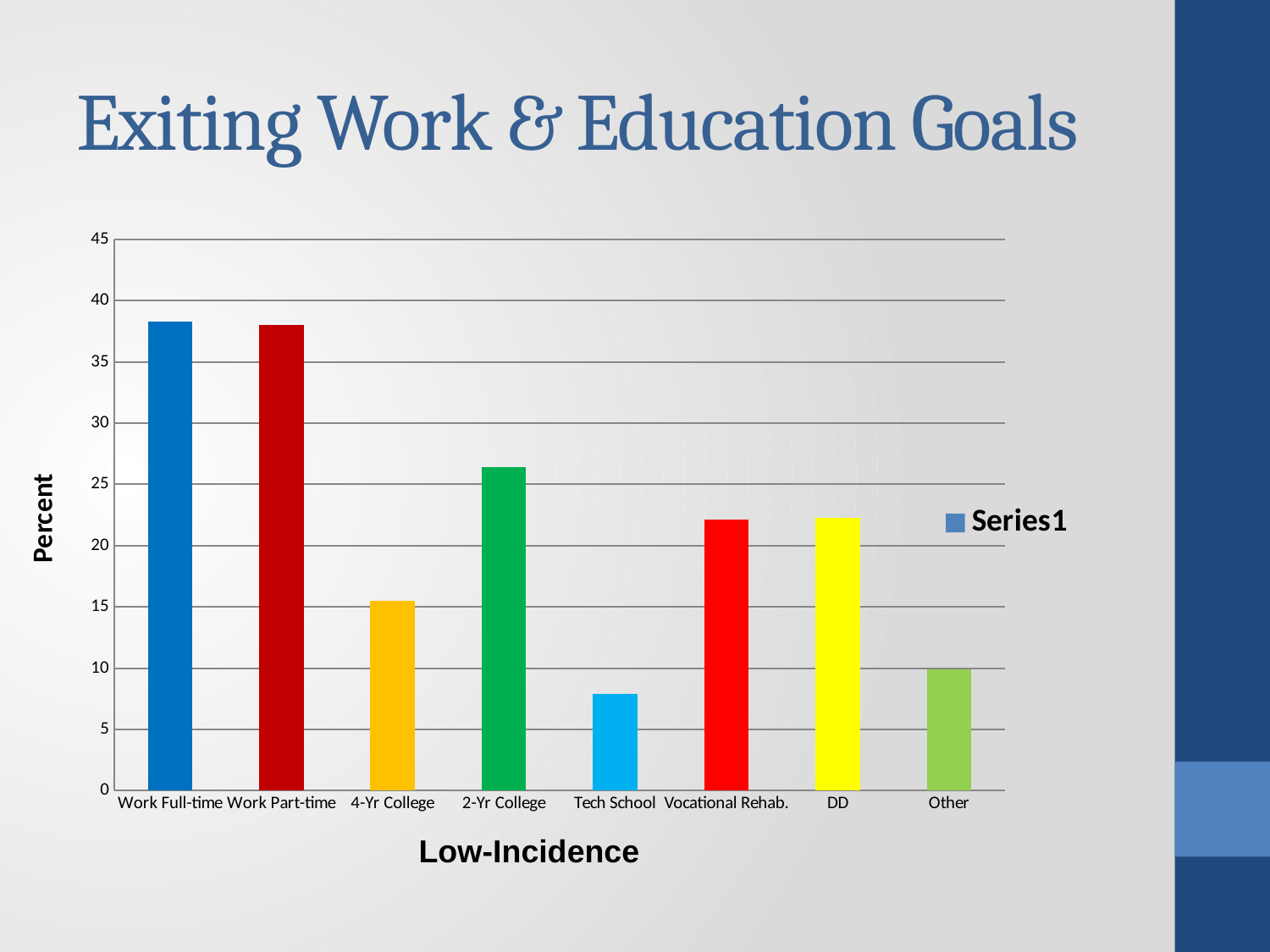
What is the title of the y axis of the chart? Percent What kind of chart is shown on the slide? bar chart Is the value for Vocational Rehab. greater or less than 20? greater Is the value for Work Full-time greater or less than 35? greater Which category has the lowest value in the chart? Tech School Is the value for 2-Yr College greater or less than 25? greater How many series does the chart legend list? 1 Which is larger, the value for 2-Yr College or the value for 4-Yr College? 2-Yr College How many categories are shown on the x axis of the chart? 8 Which is larger, the value for Work Full-time or the value for Other? Work Full-time What is the title of the x axis of the chart? Low-Incidence